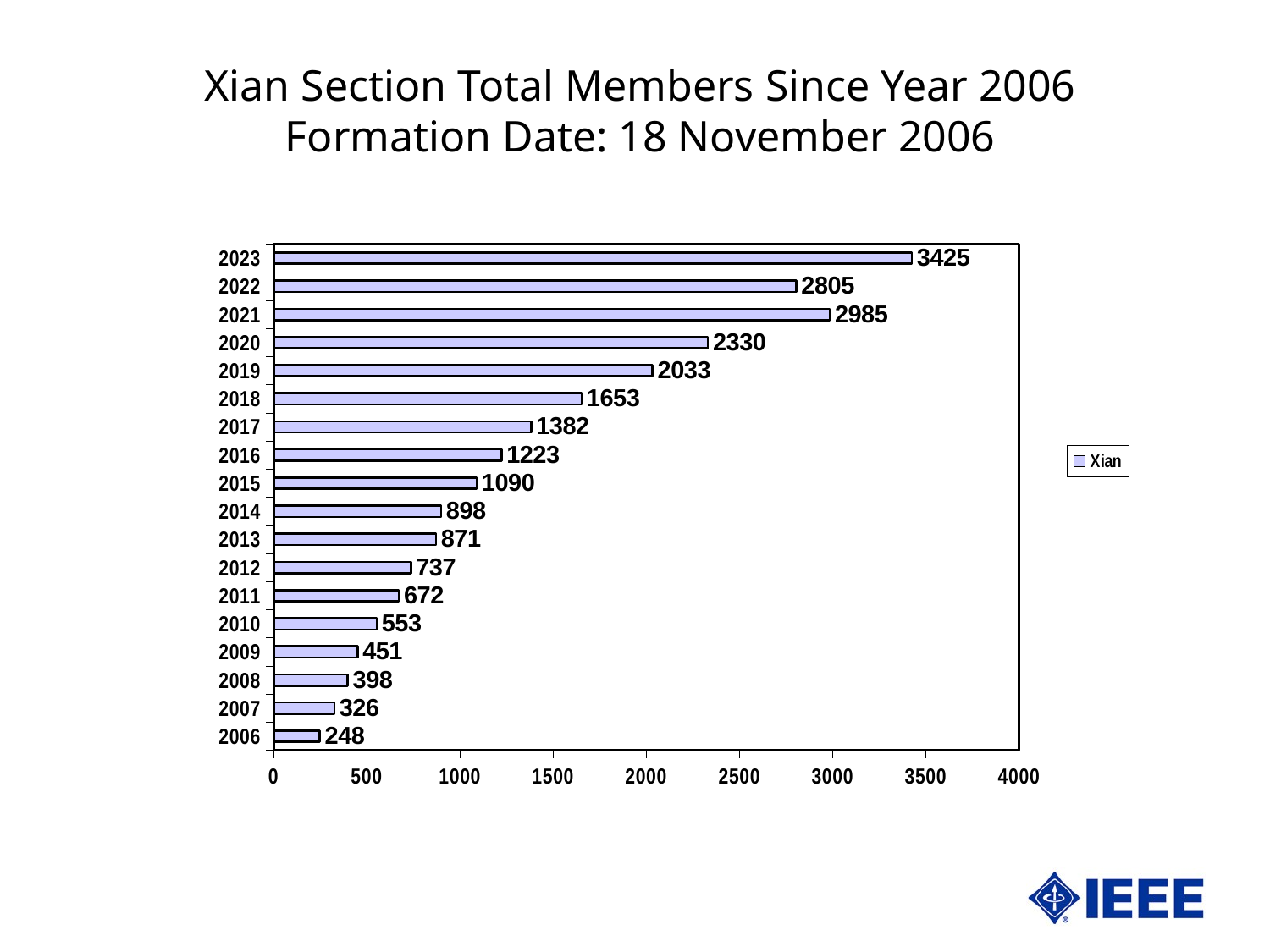
Which year had more members, 2021 or 2022? 2021 What is the total number of Xian Section members in 2006? 248 What is the total number of Xian Section members in 2015? 1090 What kind of chart is shown on the slide? bar chart How many years are shown on the chart? 18 Which year has the lowest number of members? 2006 What is the difference in members between 2021 and 2022? 180 What is the name of the series shown in the legend? Xian What is the total number of Xian Section members in 2023? 3425 How many series does the legend list? 1 Which year has the highest number of members? 2023 Is the value for 2019 greater or less than 2000? greater